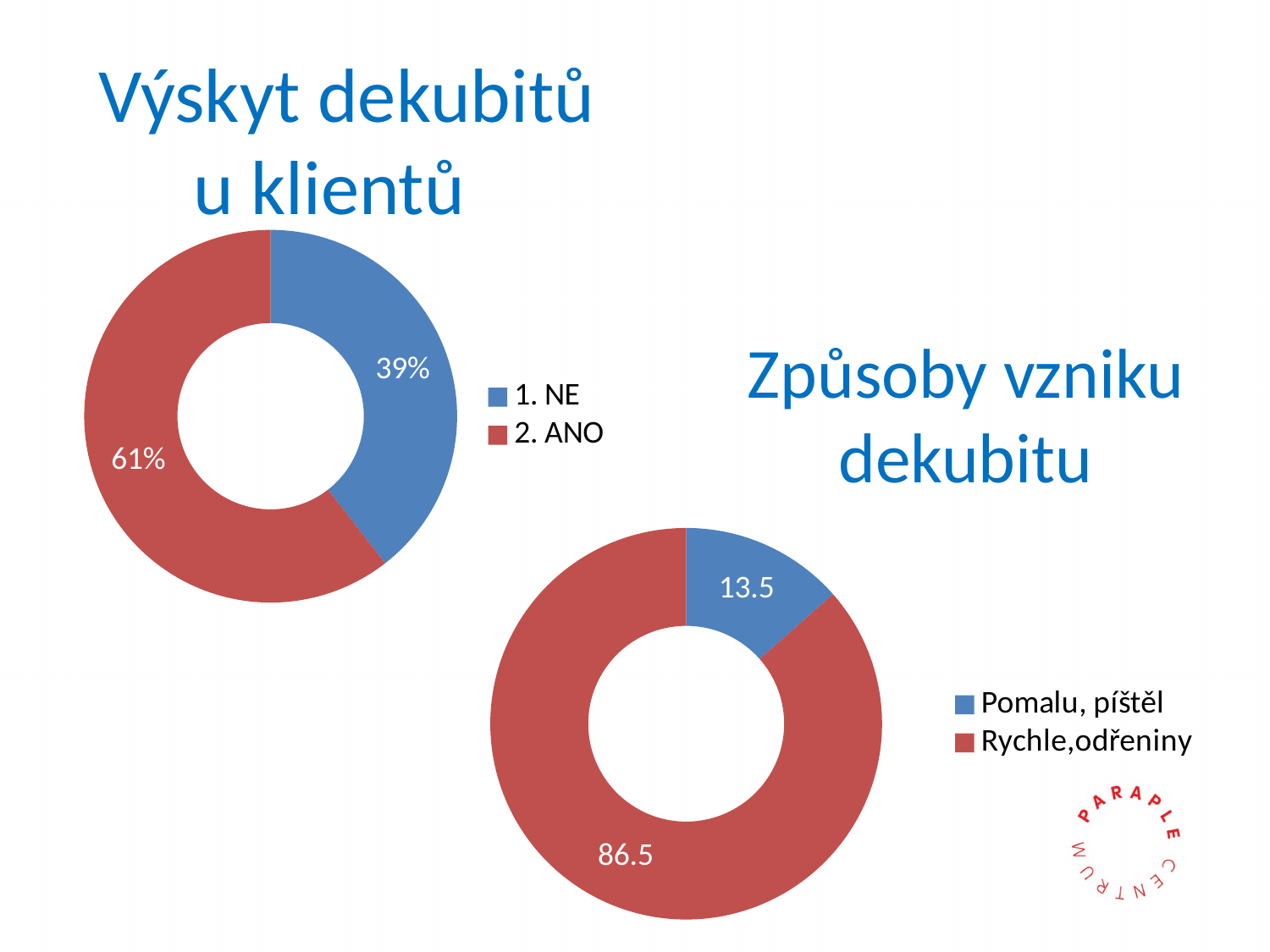
In the chart titled "Způsoby vzniku dekubitu", what is the difference between the values for "Rychle,odřeniny" and "Pomalu, píštěl"? 73 In the chart titled "Výskyt dekubitů u klientů", what is the value for "1. NE"? 39% How many categories does the chart titled "Výskyt dekubitů u klientů" show? 2 In the chart titled "Způsoby vzniku dekubitu", what is the value for "Pomalu, píštěl"? 13.5 In the chart titled "Výskyt dekubitů u klientů", what colour is the "1. NE" slice? Blue In the chart titled "Výskyt dekubitů u klientů", what is the value for "2. ANO"? 61% In the chart titled "Způsoby vzniku dekubitu", what is the value for "Rychle,odřeniny"? 86.5 In the chart titled "Způsoby vzniku dekubitu", which category has the smallest share? Pomalu, píštěl In the chart titled "Způsoby vzniku dekubitu", which is larger: "Pomalu, píštěl" or "Rychle,odřeniny"? Rychle,odřeniny In the chart titled "Výskyt dekubitů u klientů", which category has the largest share? 2. ANO In the chart titled "Výskyt dekubitů u klientů", what is the difference between the values for "2. ANO" and "1. NE"? 22% What kind of chart is the chart titled "Způsoby vzniku dekubitu"? Doughnut (pie) chart